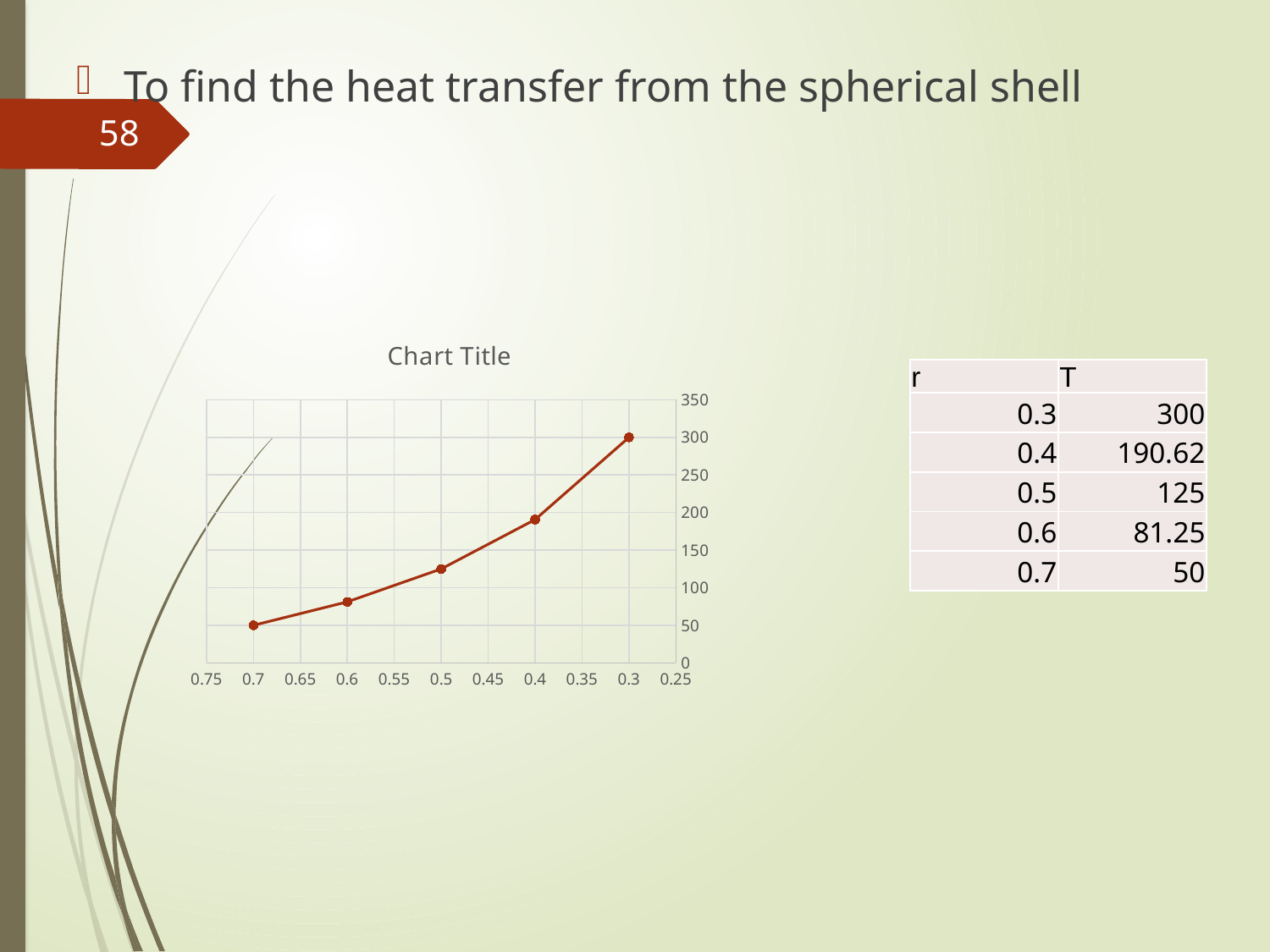
What kind of chart is shown on the slide? line chart Do the plotted values rise or fall moving from left to right along the x axis? rise What is the title of the chart? Chart Title What is the value of T at r = 0.3? 300 What is the difference between T at r = 0.3 and T at r = 0.7? 250 At which value of r is T lowest? 0.7 What is the value of T at r = 0.4? 190.62 What is the value of T at r = 0.7? 50 How many data points are plotted on the line? 5 Is the value of T at r = 0.6 greater or less than 100? less What is the value of T at r = 0.5? 125 At which value of r is T highest? 0.3